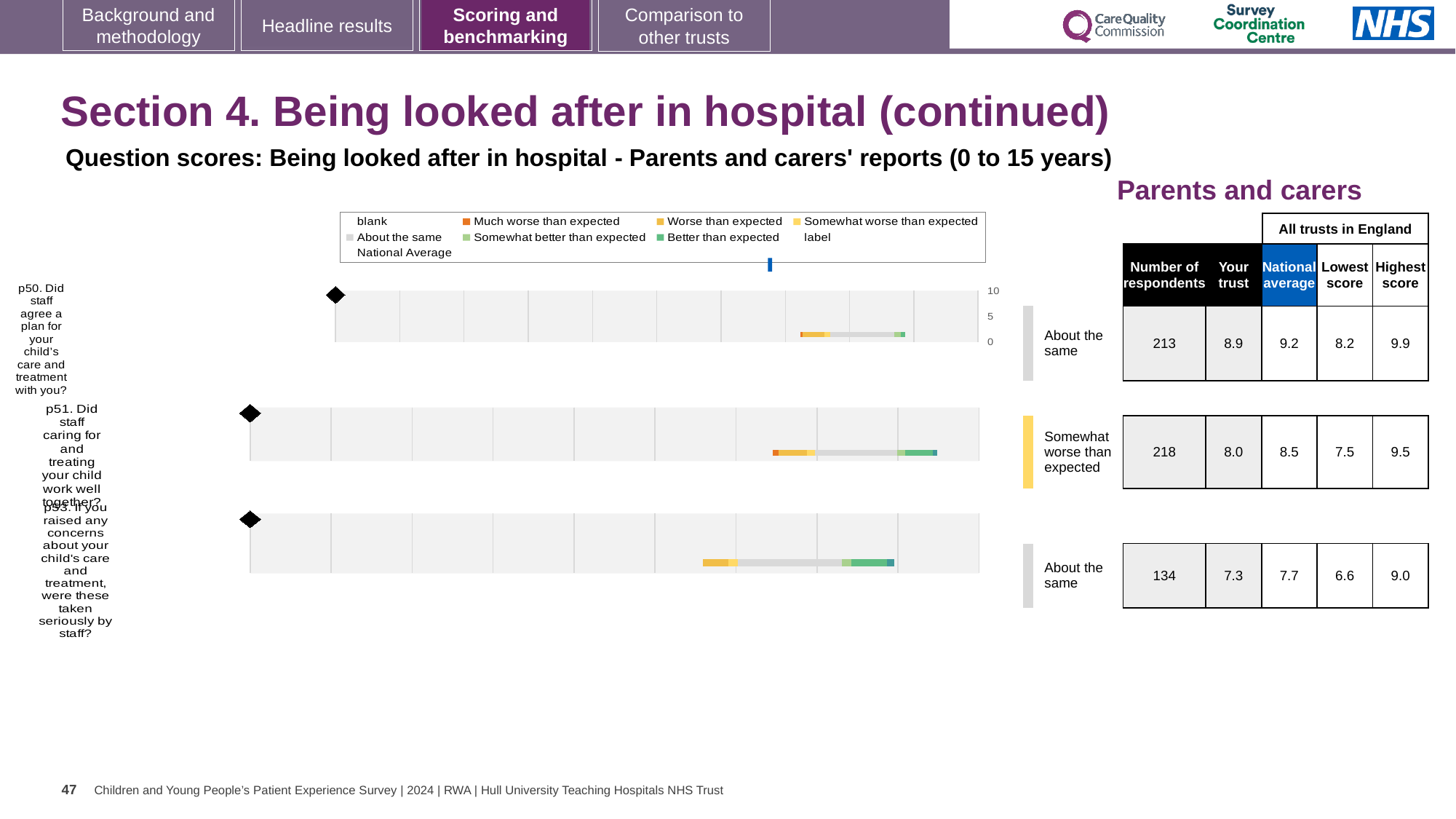
What is the 'Your trust' score for p50 (Did staff agree a plan for your child's care and treatment with you?)? 8.9 What is the difference between the highest score and the lowest score for p50? 1.7 What is the national average score for p51 (Did staff caring for and treating your child work well together?)? 8.5 For p53, which is larger: the 'Your trust' score or the national average? National average What kind of chart is used to show the question scores on this slide? bar chart How many respondents answered p53 (If you raised any concerns about your child's care and treatment, were these taken seriously by staff?)? 134 Which legend entry is shown in orange? Much worse than expected Which question has the highest 'Your trust' score? p50 How many survey questions are plotted on this slide? 3 What is the lowest score across all trusts in England for p53? 6.6 Which question has the lowest number of respondents? p53 What benchmark category is shown for p51? Somewhat worse than expected